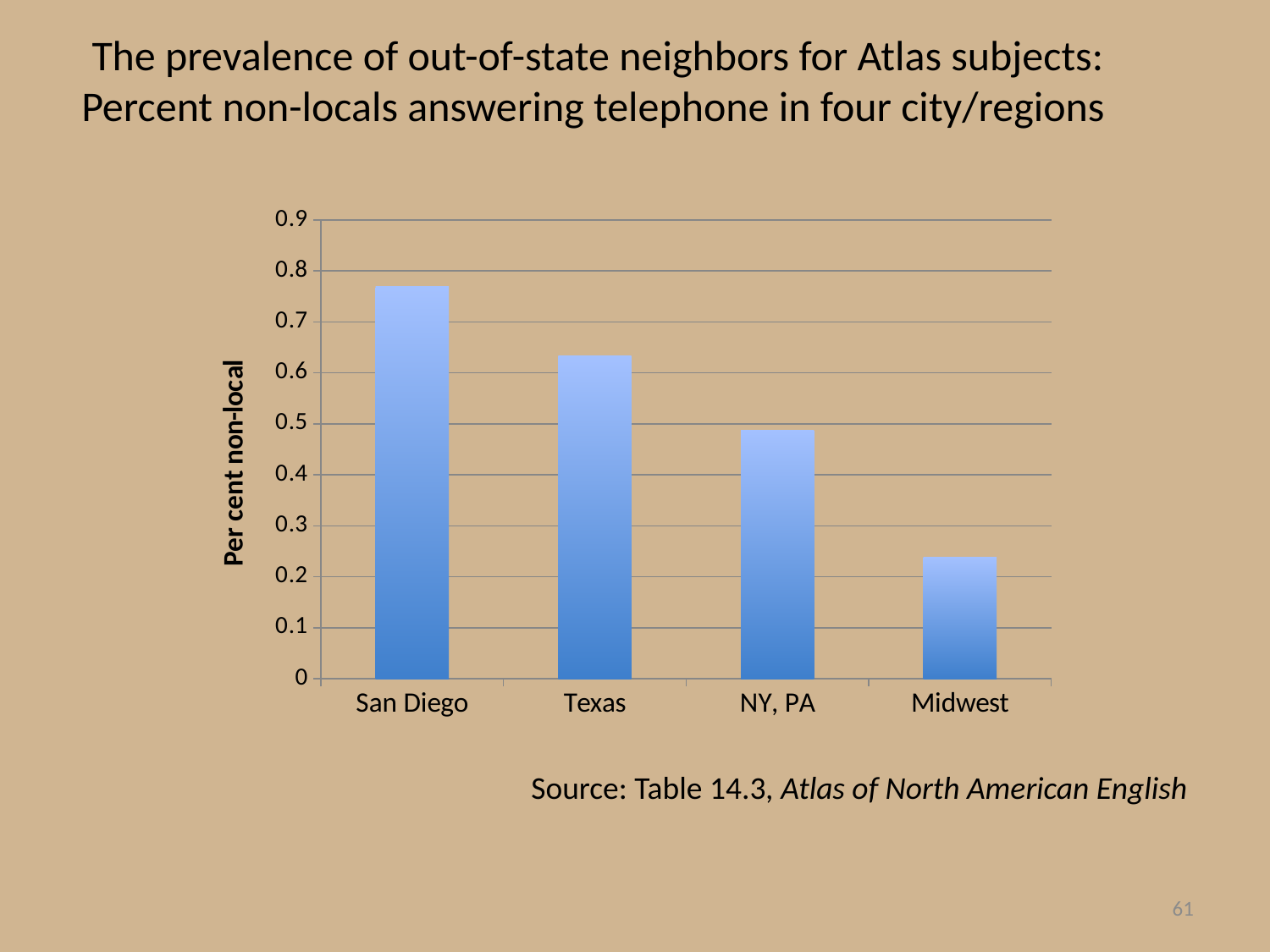
What is the label on the vertical axis of the chart? Per cent non-local Do the values rise or fall moving from San Diego to Midwest along the x axis? fall Is the value for NY, PA greater or less than 0.4? greater Which has a larger per cent non-local, Texas or NY, PA? Texas Is the value for Midwest greater or less than 0.3? less Is the value for Texas greater or less than 0.7? less What kind of chart is shown on the slide? bar chart Which city/region has the lowest per cent non-local? Midwest What source is cited below the chart? Table 14.3, Atlas of North American English Which city/region has the highest per cent non-local? San Diego How many city/regions are plotted in the chart? 4